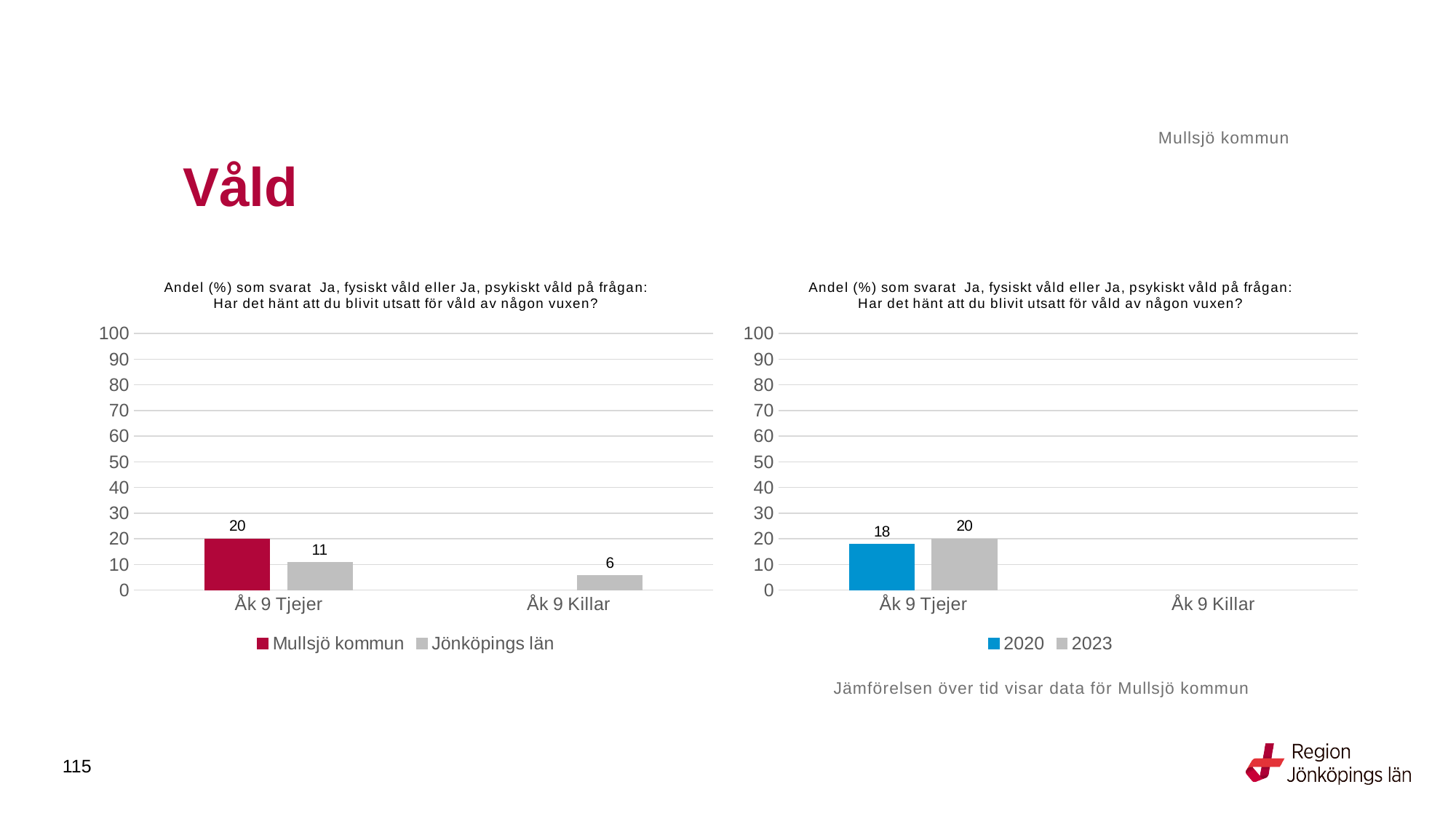
What kind of chart is the right chart? Bar chart In the right chart, what is the difference between the 2023 and 2020 values for Åk 9 Tjejer? 2 In the right chart, which year has the higher value for Åk 9 Tjejer, 2020 or 2023? 2023 In the left chart, how many series does the legend list? 2 In the left chart, what is the value for Mullsjö kommun for Åk 9 Tjejer? 20 In the right chart, what are the two legend entries? 2020 and 2023 In the left chart, what is the difference between Mullsjö kommun and Jönköpings län for Åk 9 Tjejer? 9 In the left chart, which series has the higher value for Åk 9 Tjejer, Mullsjö kommun or Jönköpings län? Mullsjö kommun In the right chart, what is the value for 2023 for Åk 9 Tjejer? 20 In the left chart, what is the value for Jönköpings län for Åk 9 Killar? 6 In the left chart, what is the value for Jönköpings län for Åk 9 Tjejer? 11 In the right chart, what is the value for 2020 for Åk 9 Tjejer? 18